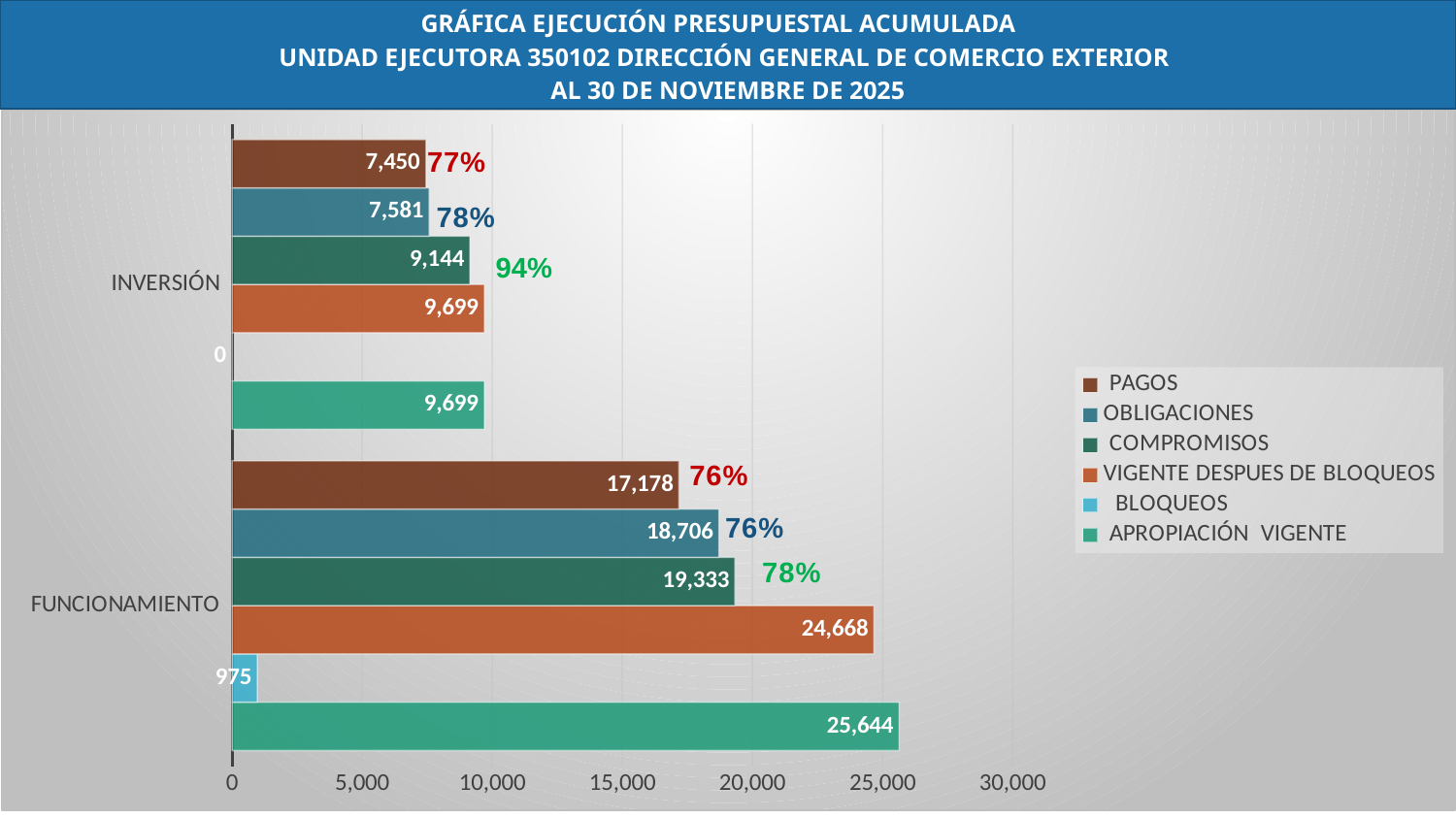
What is the value of OBLIGACIONES for FUNCIONAMIENTO? 18,706 What percentage is shown next to the COMPROMISOS bar for INVERSIÓN? 94% What kind of chart is shown on the slide? Bar chart Which is larger for INVERSIÓN: OBLIGACIONES or PAGOS? OBLIGACIONES What is the difference between APROPIACIÓN VIGENTE and VIGENTE DESPUES DE BLOQUEOS for FUNCIONAMIENTO? 976 How many series does the legend list? 6 Which series has the lowest value for INVERSIÓN? BLOQUEOS What is the value of APROPIACIÓN VIGENTE for INVERSIÓN? 9,699 What is the value of PAGOS for FUNCIONAMIENTO? 17,178 What is the value of BLOQUEOS for FUNCIONAMIENTO? 975 Which series has the highest value for FUNCIONAMIENTO? APROPIACIÓN VIGENTE What is the value of COMPROMISOS for INVERSIÓN? 9,144